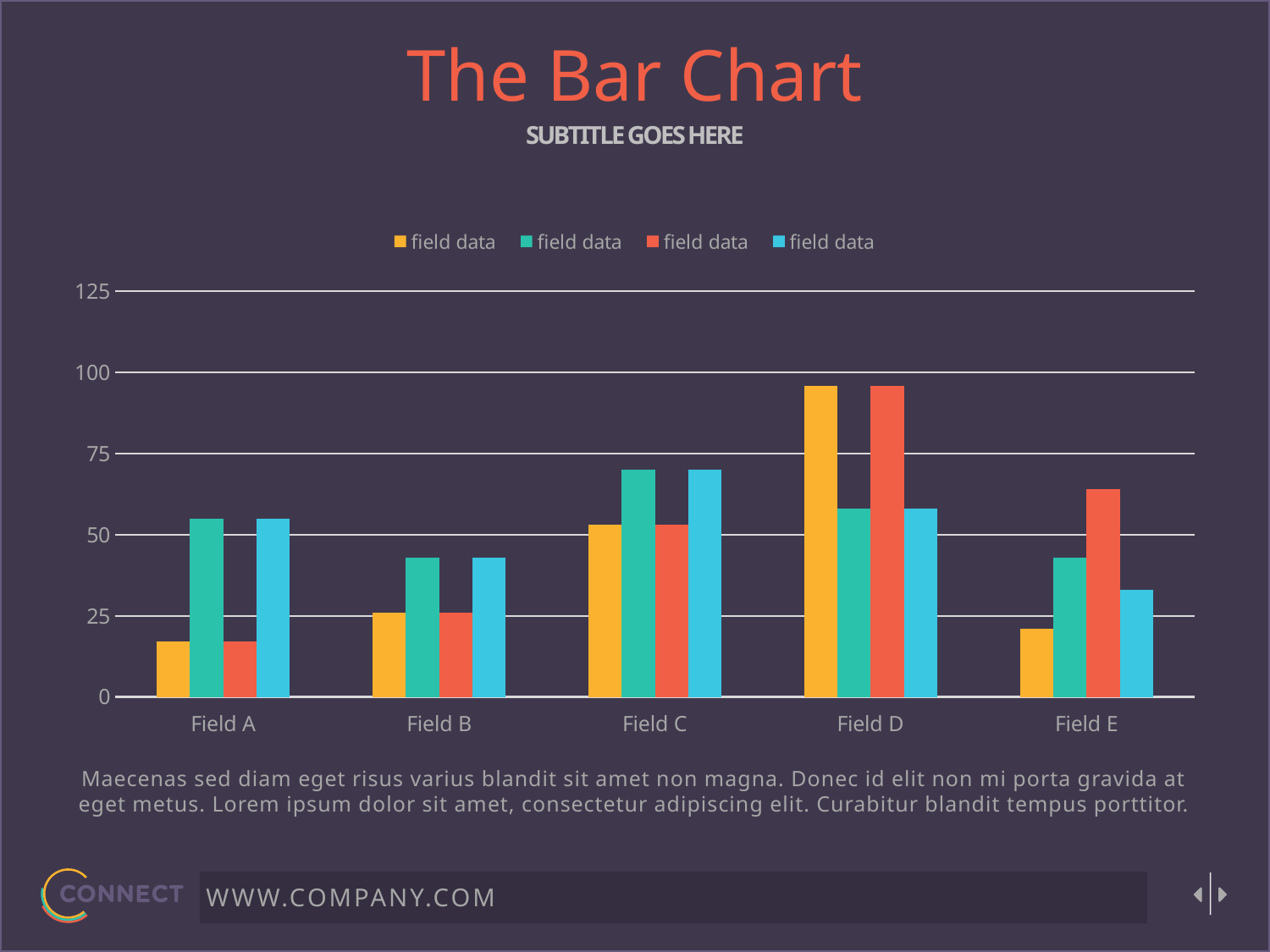
Is the value of the yellow bar for Field D greater or less than 75? greater Is the value of the red bar for Field E greater or less than 50? greater Is the value of the yellow bar for Field A greater or less than 25? less For Field E, which is larger: the red bar or the blue bar? the red bar Which category has the highest yellow bar? Field D What label is given to every series in the legend? field data What is the title of the slide containing the chart? The Bar Chart How many series does the legend list? 4 What kind of chart is shown on the slide? bar chart Which category has the highest green bar? Field C How many categories are shown on the x axis? 5